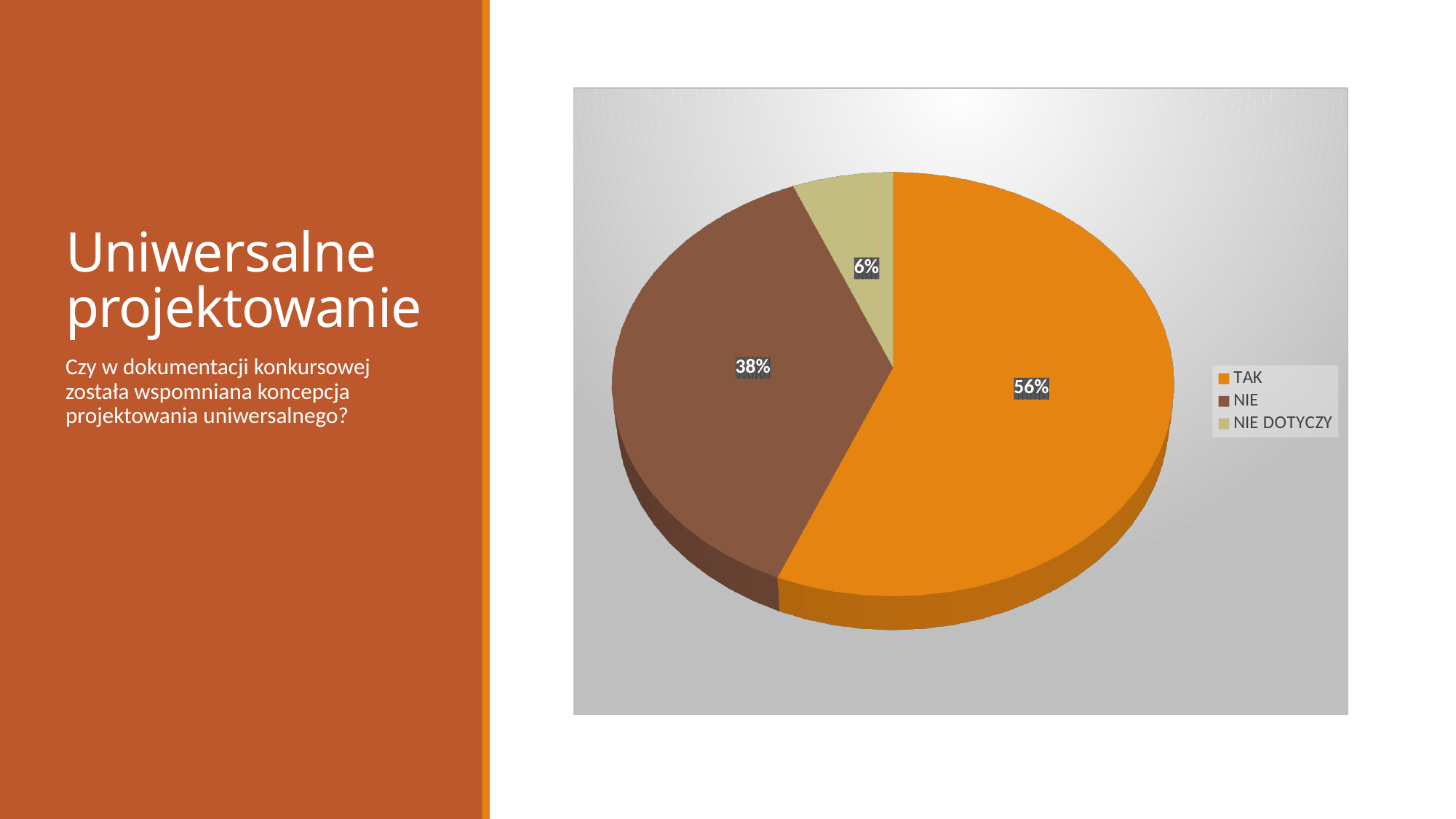
Which category has the smallest slice of the pie? NIE DOTYCZY What share of the pie does NIE DOTYCZY represent? 6% Which category has the largest slice of the pie? TAK What share of the pie does NIE represent? 38% How many entries does the legend list? 3 How many slices does the pie chart have? 3 What is the difference in percentage points between the TAK and NIE slices? 18 What colour is the TAK slice? Orange What kind of chart is shown on the slide? Pie chart What is the difference in percentage points between the NIE and NIE DOTYCZY slices? 32 What share of the pie does TAK represent? 56% Which slice is larger, NIE or NIE DOTYCZY? NIE